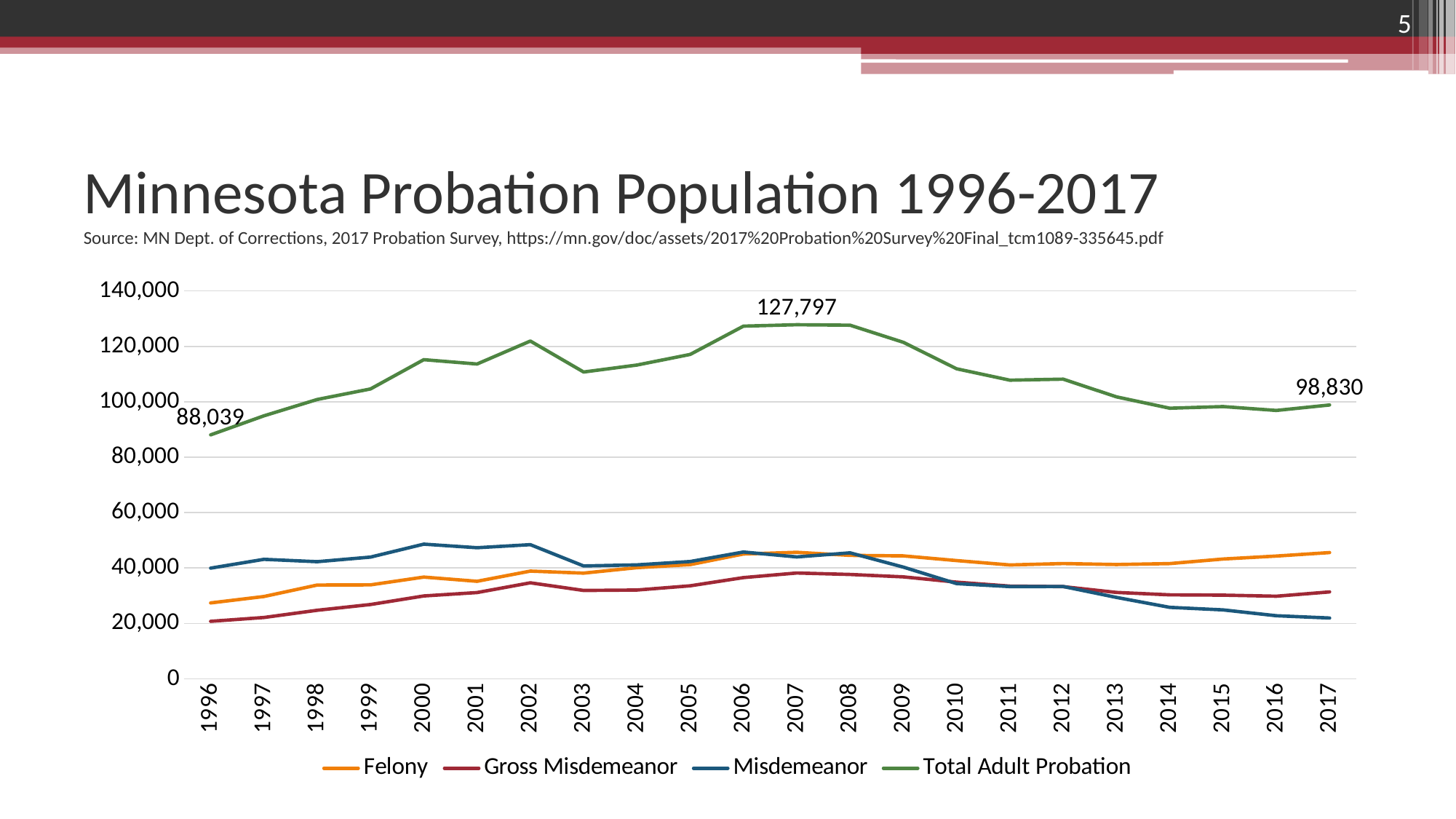
By how much did Total Adult Probation increase from 1996 to its 2007 peak? 39,758 Is the Misdemeanor value for 2017 greater or less than 40,000? less How many years are plotted along the x axis? 22 What was the Total Adult Probation value in 2017? 98,830 Among Felony, Gross Misdemeanor and Misdemeanor, which series is highest in 2017? Felony Which is larger, the Total Adult Probation value in 1996 or in 2017? 2017 What was the Total Adult Probation value in 1996? 88,039 What is the difference between the Total Adult Probation values in 2007 and 2017? 28,967 Does the Misdemeanor line rise or fall from 2008 to 2017? Fall What was the Total Adult Probation value in 2007? 127,797 How many series does the legend list? 4 What kind of chart is shown on the slide? Line chart